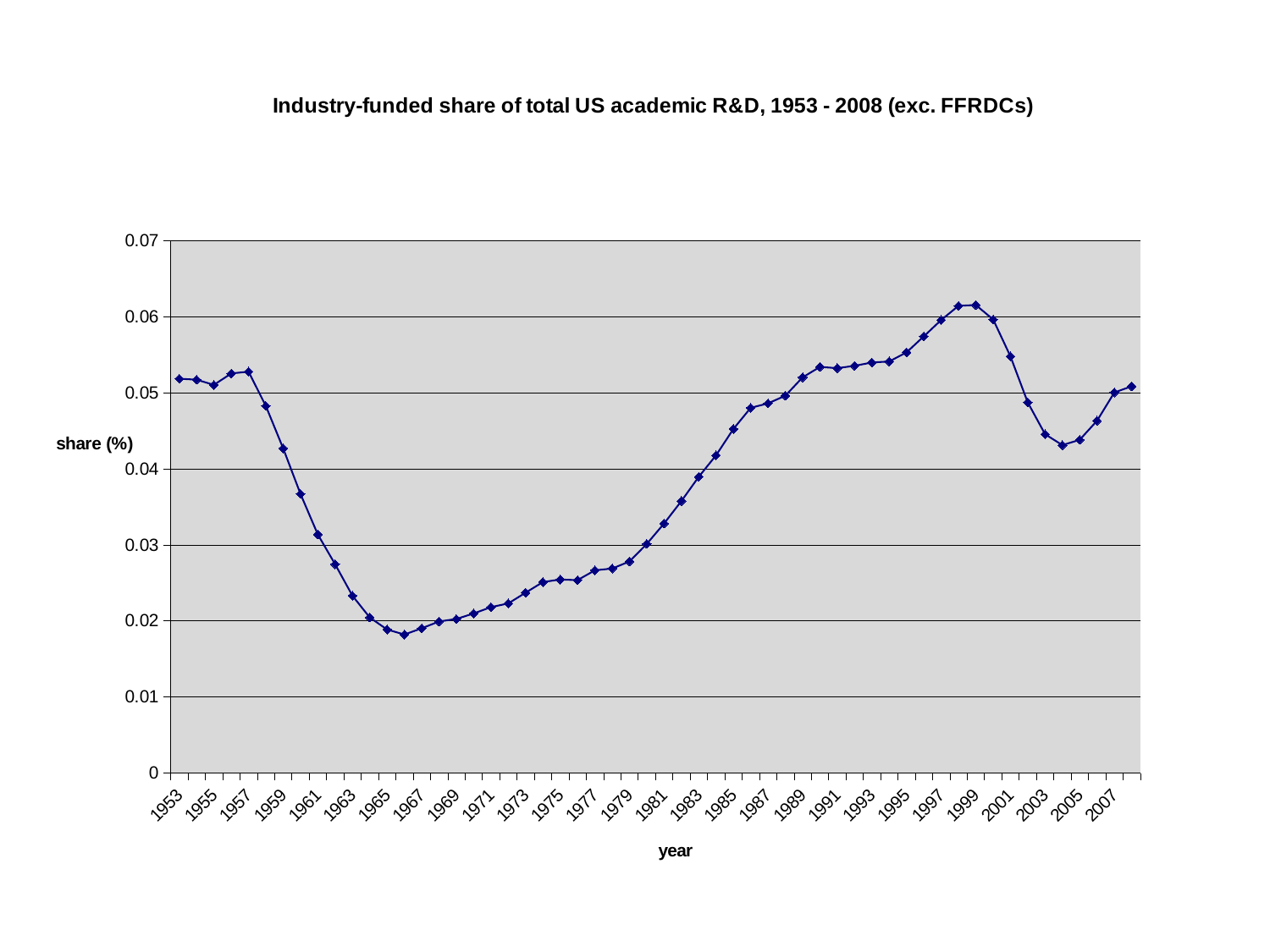
Is the value for 1966 greater or less than 0.02? less What is the label of the vertical axis? share (%) Do the values rise or fall between 1966 and 1998? rise Which year has the larger value, 1980 or 1990? 1990 Is the value for 1953 greater or less than 0.04? greater What kind of chart is shown on the slide? line chart Which year has the larger value, 1999 or 2004? 1999 Is the value for 1985 greater or less than 0.05? less What is the title of the chart? Industry-funded share of total US academic R&D, 1953 - 2008 (exc. FFRDCs) Do the values rise or fall between 1957 and 1966? fall